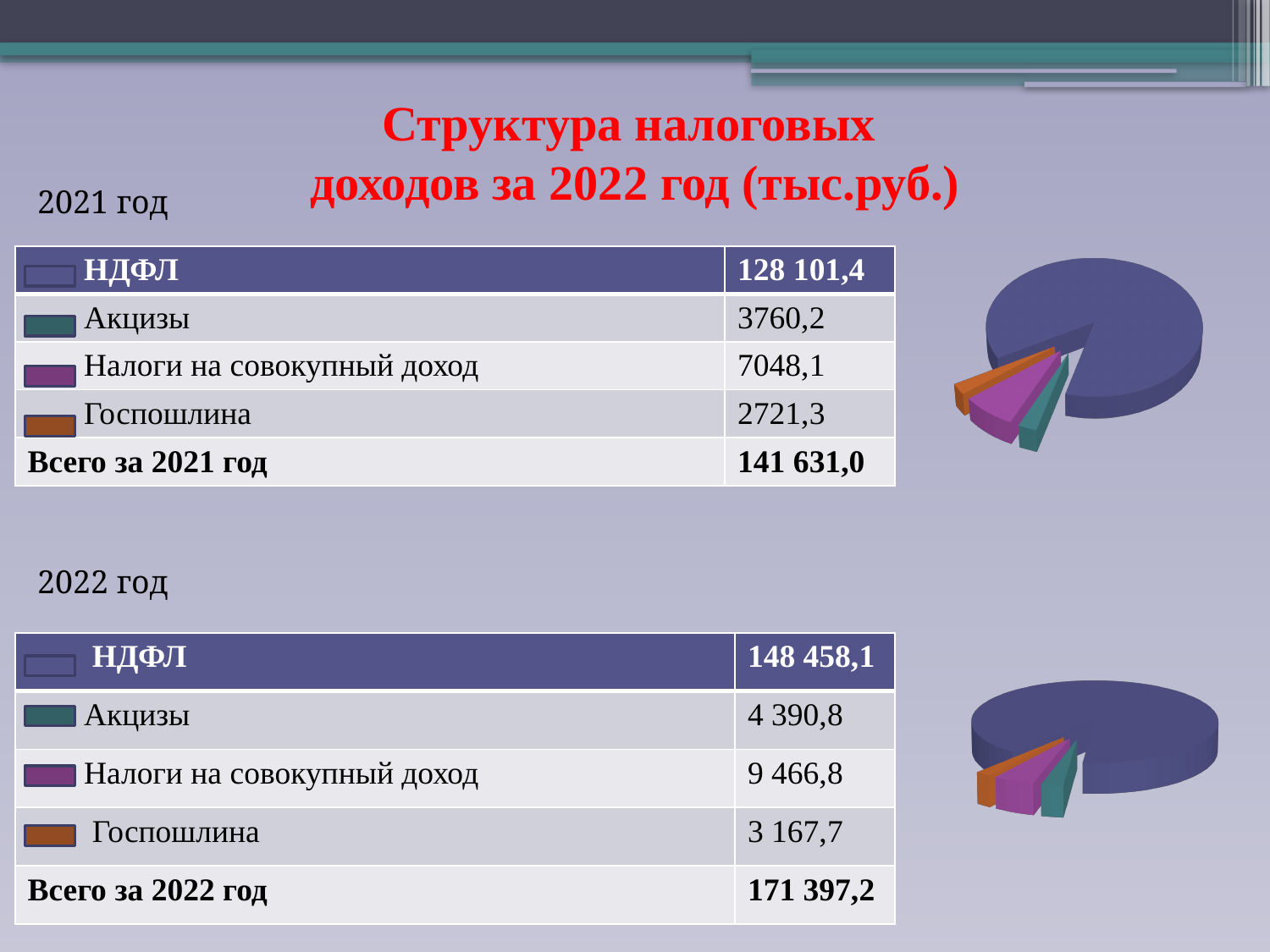
In the 2022 chart, which is larger: Акцизы or Налоги на совокупный доход? Налоги на совокупный доход What kind of chart is shown next to the 2021 table? pie chart In the 2022 chart, what is the value for Налоги на совокупный доход? 9 466,8 What colour is the НДФЛ slice in both pie charts? dark blue/purple In the 2021 pie chart, how many slices are there? 4 In the 2021 pie chart, which category has the largest slice? НДФЛ In the 2021 chart, what is the total of all categories (Всего за 2021 год)? 141 631,0 In the 2022 pie chart, which category has the largest slice? НДФЛ In the 2021 pie chart, which category has the smallest slice? Госпошлина In the 2022 chart, what is the value for Госпошлина? 3 167,7 In the 2021 chart, what is the value for Акцизы? 3760,2 In the 2022 chart, what is the difference between НДФЛ and Акцизы? 144 067,3